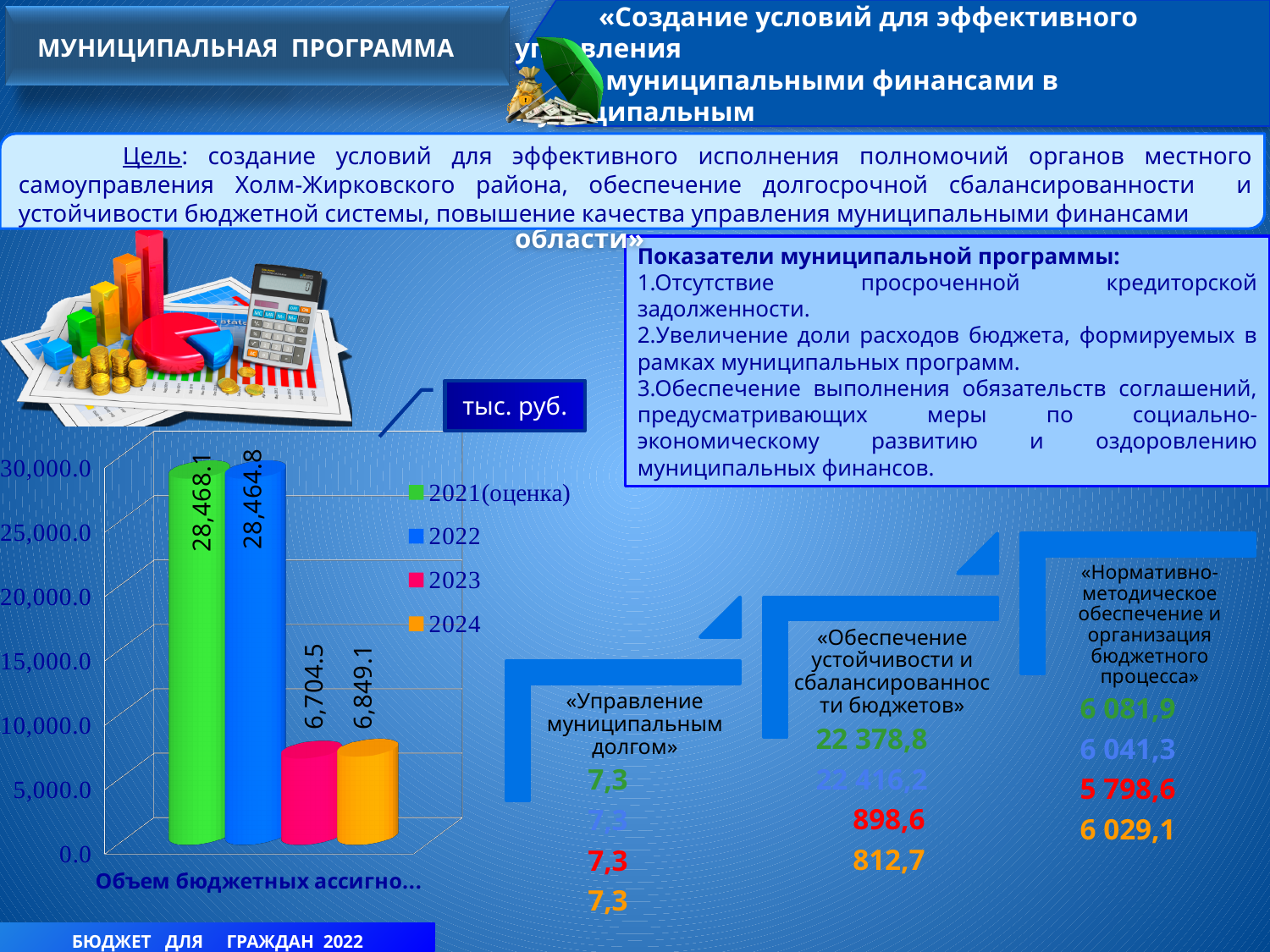
Which series has the highest value in the bar chart? 2021(оценка) What is the value for the 2022 series in the bar chart? 28,464.8 What is the value for the 2024 series in the bar chart? 6,849.1 Which is larger in the bar chart, the value for 2023 or the value for 2024? 2024 How many series does the legend of the bar chart list? 4 What is the value for the 2021(оценка) series in the bar chart? 28,468.1 What is the difference between the 2021(оценка) value and the 2023 value in the bar chart? 21,763.6 What is the difference between the 2024 value and the 2023 value in the bar chart? 144.6 What kind of chart is shown on the slide? bar chart Is the value for 2023 in the bar chart greater or less than 10,000.0? less What is the value for the 2023 series in the bar chart? 6,704.5 Which series has the lowest value in the bar chart? 2023